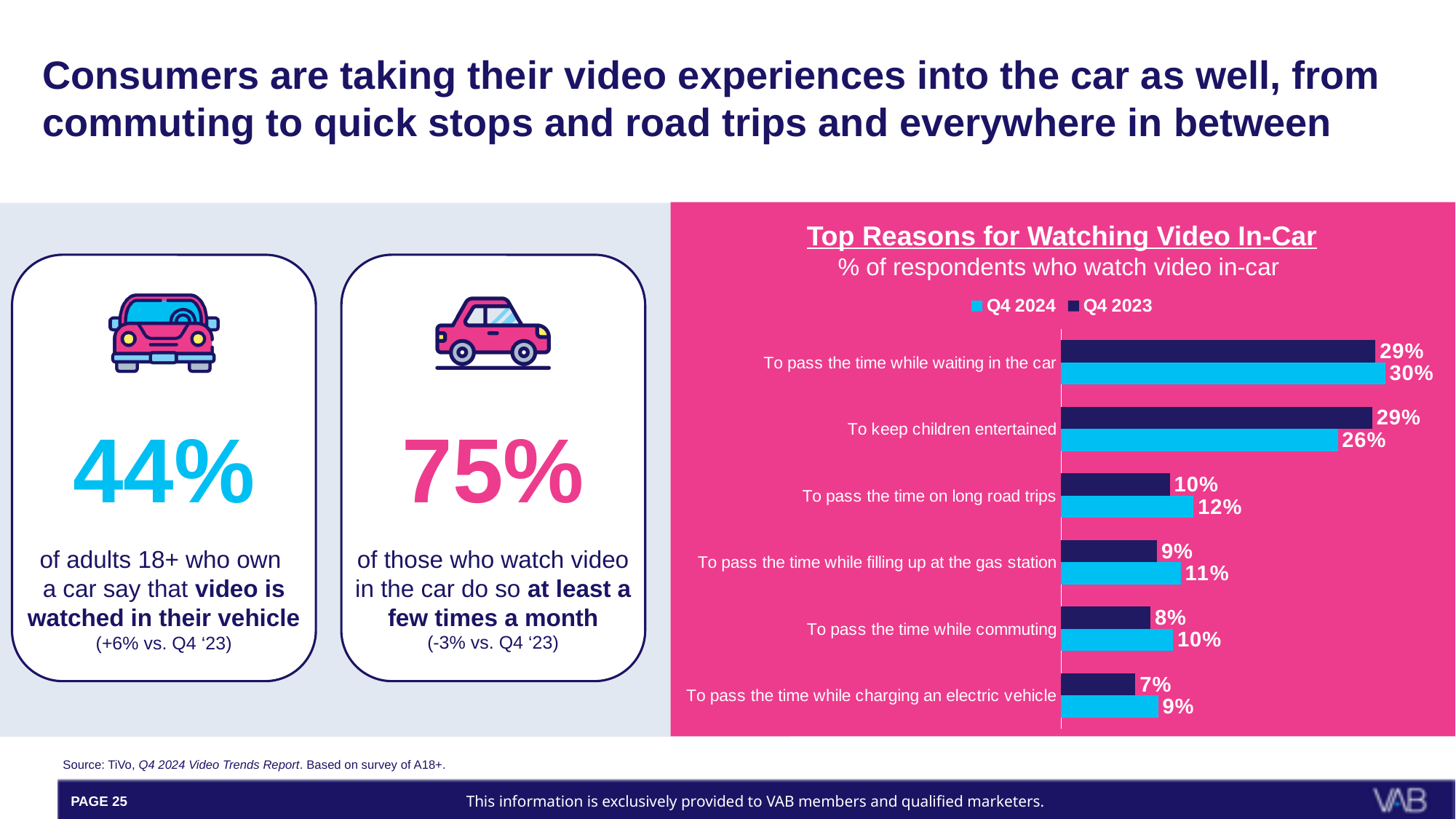
In the 'Top Reasons for Watching Video In-Car' chart, what is the Q4 2023 value for 'To keep children entertained'? 29% How many series does the legend of the 'Top Reasons for Watching Video In-Car' chart list? 2 In the 'Top Reasons for Watching Video In-Car' chart, is the Q4 2024 value for 'To pass the time on long road trips' larger or smaller than its Q4 2023 value? larger In the 'Top Reasons for Watching Video In-Car' chart, what is the difference between the Q4 2023 and Q4 2024 values for 'To keep children entertained'? 3% In the 'Top Reasons for Watching Video In-Car' chart, what is the Q4 2024 value for 'To pass the time while waiting in the car'? 30% In the 'Top Reasons for Watching Video In-Car' chart, what is the Q4 2024 value for 'To pass the time while commuting'? 10% What colour represents the Q4 2023 series in the 'Top Reasons for Watching Video In-Car' chart? dark navy In the 'Top Reasons for Watching Video In-Car' chart, what is the difference between the Q4 2024 and Q4 2023 values for 'To pass the time while filling up at the gas station'? 2% What type of chart is shown under 'Top Reasons for Watching Video In-Car'? bar chart In the 'Top Reasons for Watching Video In-Car' chart, which reason has the highest Q4 2024 value? To pass the time while waiting in the car In the 'Top Reasons for Watching Video In-Car' chart, which reason has the lowest Q4 2024 value? To pass the time while charging an electric vehicle How many reasons (categories) are shown in the 'Top Reasons for Watching Video In-Car' chart? 6